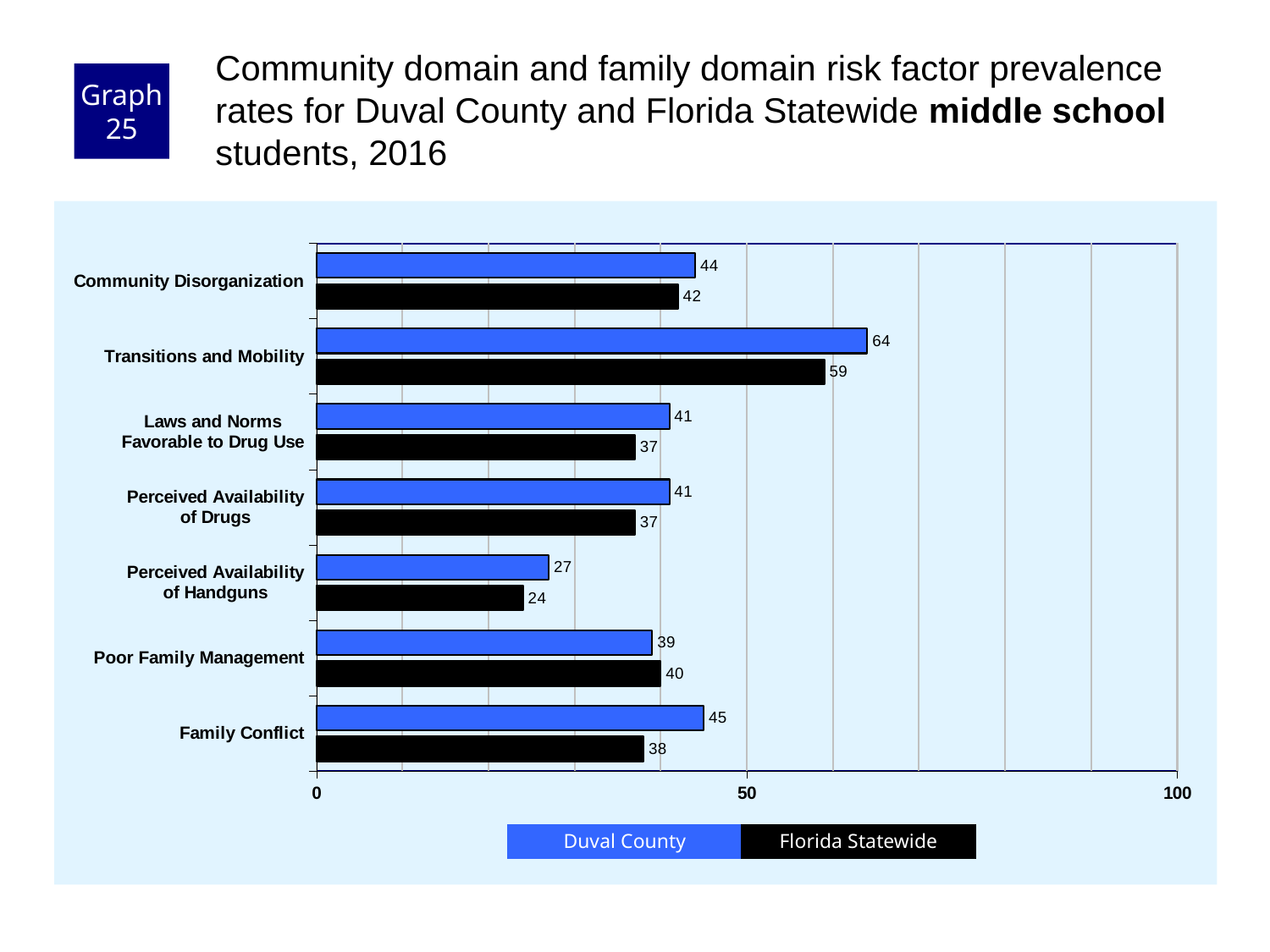
What kind of chart is shown on the slide? bar chart How many risk factor categories are shown on the chart? 7 Is the Duval County value for Transitions and Mobility greater or less than 50? greater Which colour represents Florida Statewide in the chart? black How many series does the legend list? 2 What is the difference between the Duval County and Florida Statewide values for Family Conflict? 7 What is the Florida Statewide value for Family Conflict? 38 What is the Duval County value for Transitions and Mobility? 64 What is the Florida Statewide value for Perceived Availability of Handguns? 24 Which risk factor has the highest Duval County value? Transitions and Mobility For Poor Family Management, which is larger: the Duval County value or the Florida Statewide value? Florida Statewide Which risk factor has the lowest Florida Statewide value? Perceived Availability of Handguns